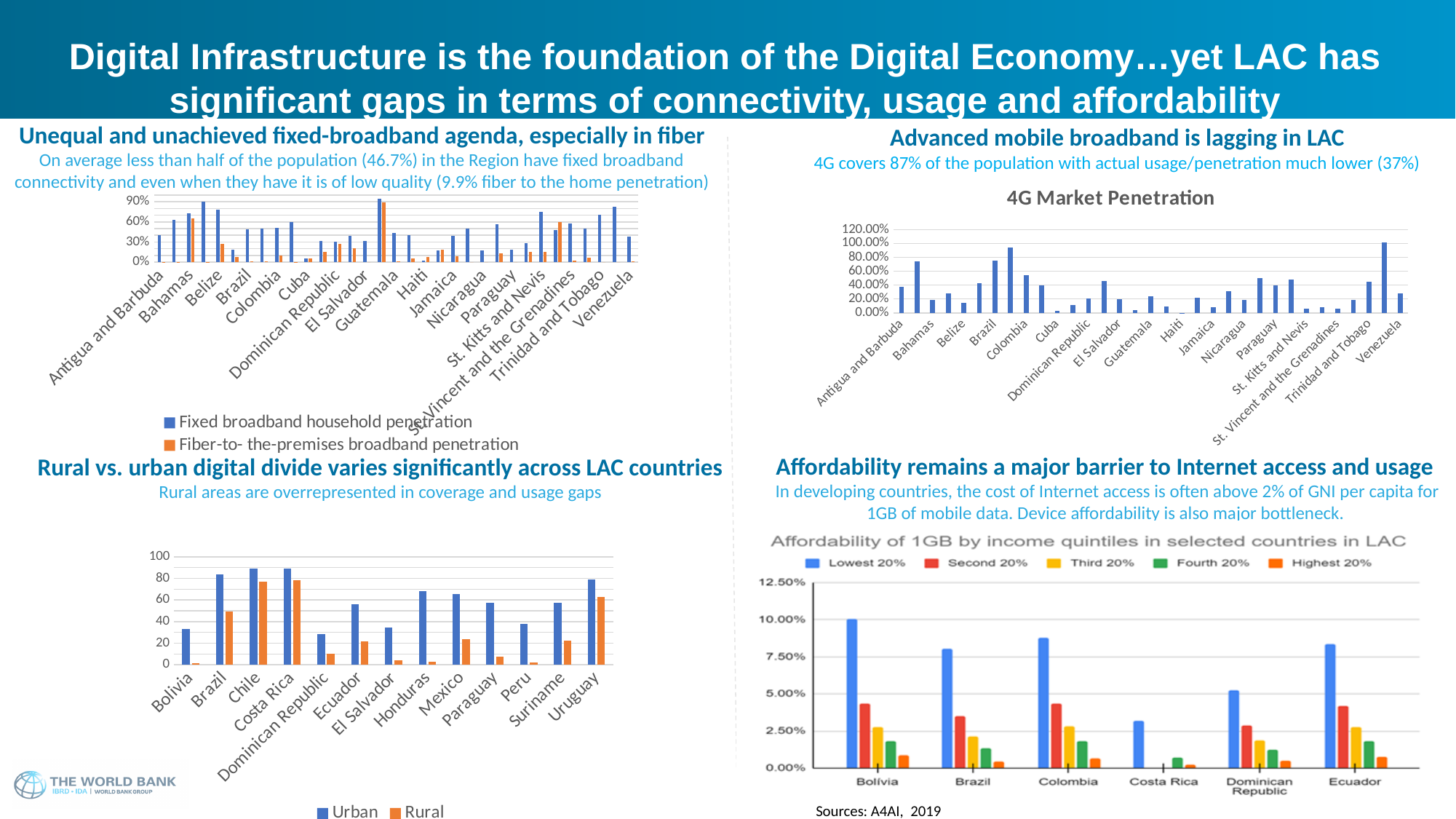
In the 'Affordability of 1GB by income quintiles in selected countries in LAC' chart, how many series does the legend list? 5 In the Urban vs Rural chart at the bottom left, which is larger: the Urban value for Uruguay or the Urban value for Peru? Uruguay What kind of chart is the '4G Market Penetration' chart? bar chart In the 'Affordability of 1GB by income quintiles in selected countries in LAC' chart, is the Lowest 20% value for Bolivia greater or less than 7.50%? greater In the '4G Market Penetration' chart, is the value for Bahamas greater or less than 60.00%? less In the Urban vs Rural chart at the bottom left, is the Urban value for Brazil greater or less than 80? greater In the 'Affordability of 1GB by income quintiles in selected countries in LAC' chart, how many countries are shown on the x axis? 6 In the Urban vs Rural chart at the bottom left, how many countries are shown on the x axis? 13 In the top-left fixed broadband chart, how many series does the legend list? 2 In the 'Affordability of 1GB by income quintiles in selected countries in LAC' chart, which country has the highest value for the Lowest 20% series? Bolivia